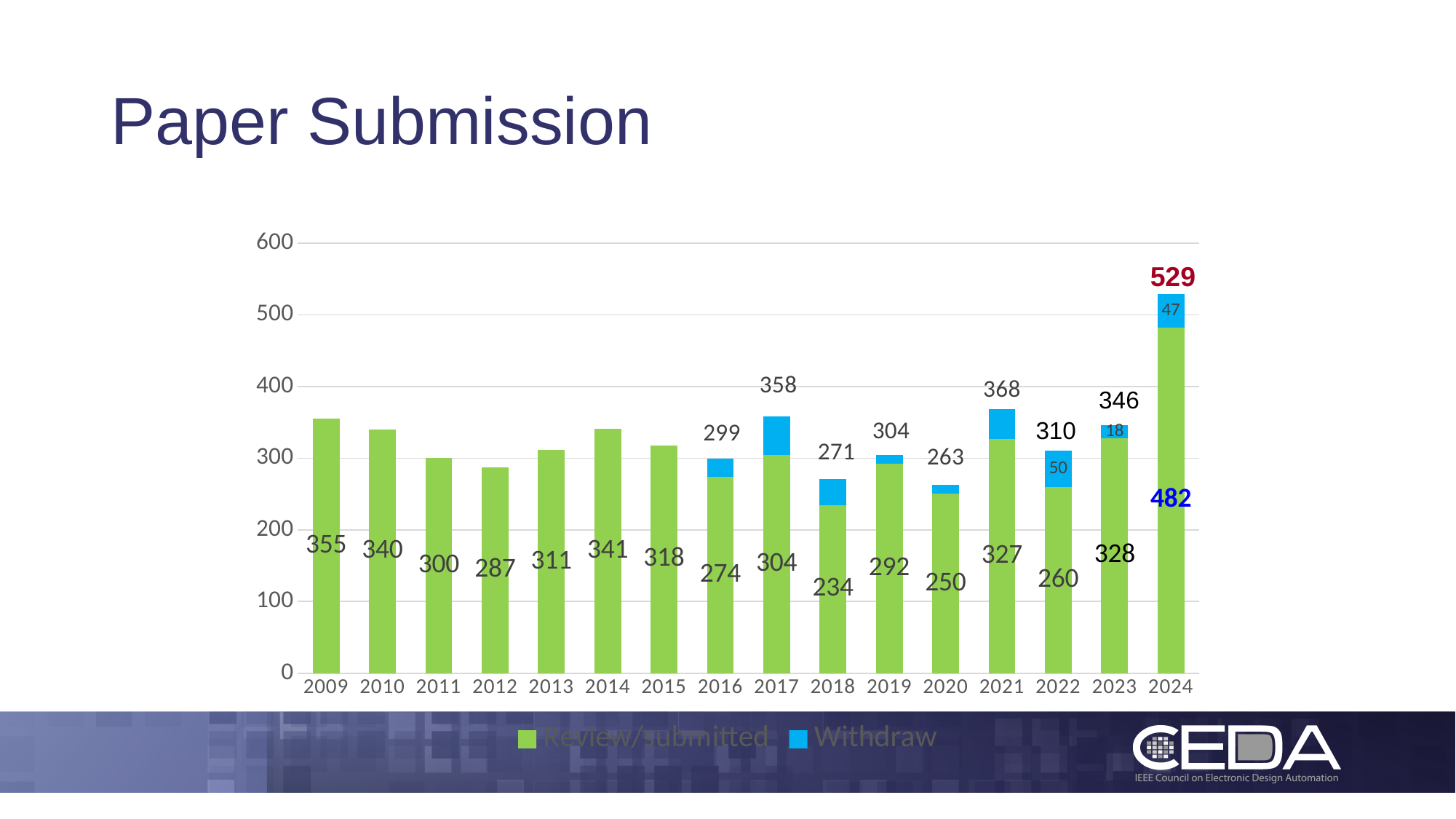
What are the two legend entries of the chart? Review/submitted and Withdraw Which year has the lowest Review/submitted value? 2018 What is the Withdraw value for 2022? 50 Which year has the larger total, 2021 or 2017? 2021 What is the Review/submitted value for 2009? 355 Which year has the highest Review/submitted value? 2024 What kind of chart is shown on the slide? stacked bar chart How many series does the legend list? 2 What is the total height of the stacked bar for 2024? 529 How many years are shown on the x axis? 16 Is the value for 2012 greater or less than 300? less What is the difference between the Review/submitted values for 2024 and 2023? 154